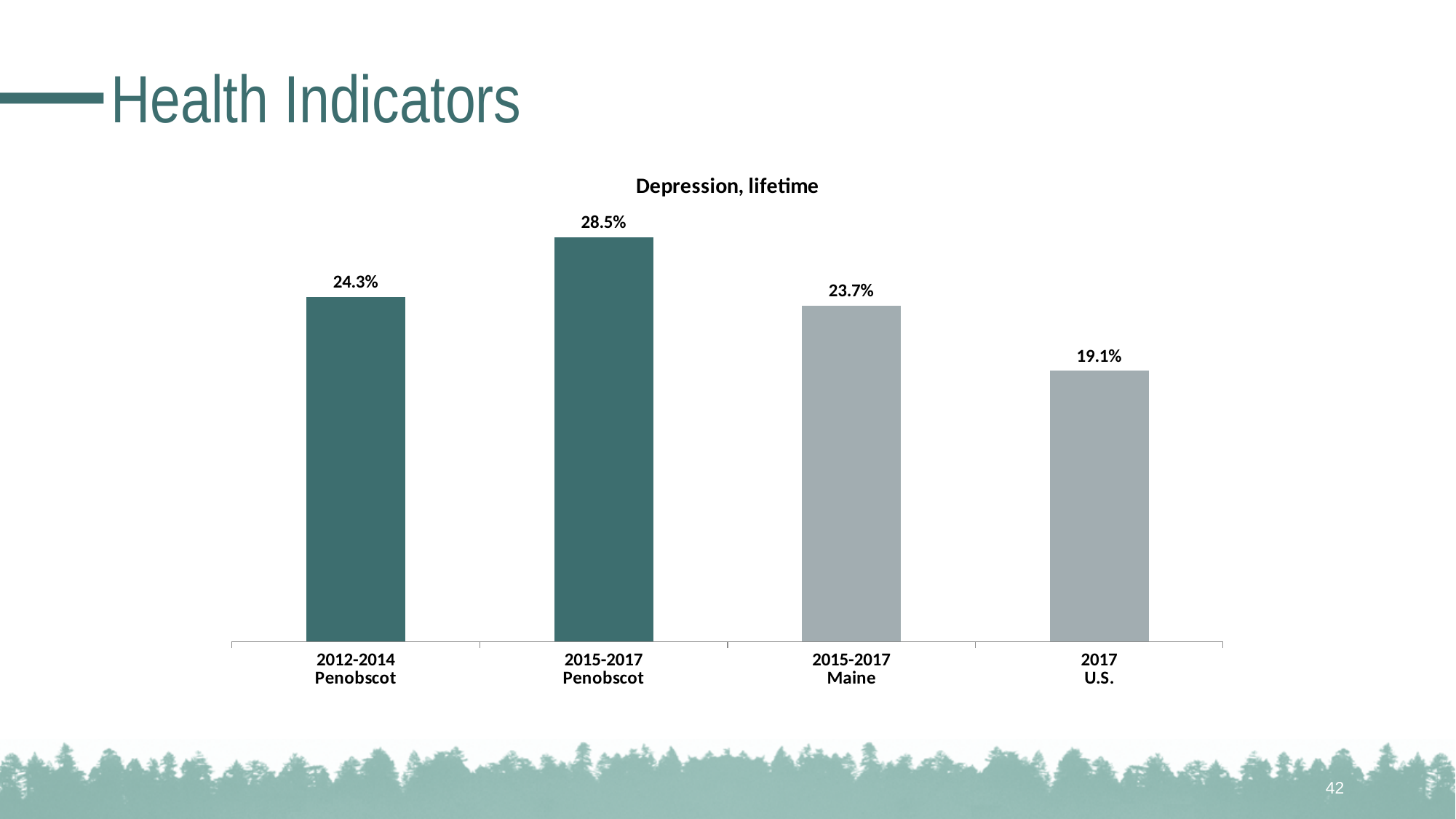
What kind of chart is shown on the slide? Bar chart Which category has the highest value in the Depression, lifetime chart? 2015-2017 Penobscot Which category has the lowest value in the Depression, lifetime chart? 2017 U.S. What is the difference between the 2015-2017 Penobscot value and the 2012-2014 Penobscot value? 4.2% How many bars are shown in the Depression, lifetime chart? 4 What is the value for 2015-2017 Maine in the Depression, lifetime chart? 23.7% What is the value for 2015-2017 Penobscot in the Depression, lifetime chart? 28.5% What is the value for 2017 U.S. in the Depression, lifetime chart? 19.1% What is the difference between the 2015-2017 Penobscot value and the 2017 U.S. value? 9.4% Which is larger, the value for 2015-2017 Maine or the value for 2017 U.S.? 2015-2017 Maine What is the title of the chart on the slide? Depression, lifetime What is the value for 2012-2014 Penobscot in the Depression, lifetime chart? 24.3%